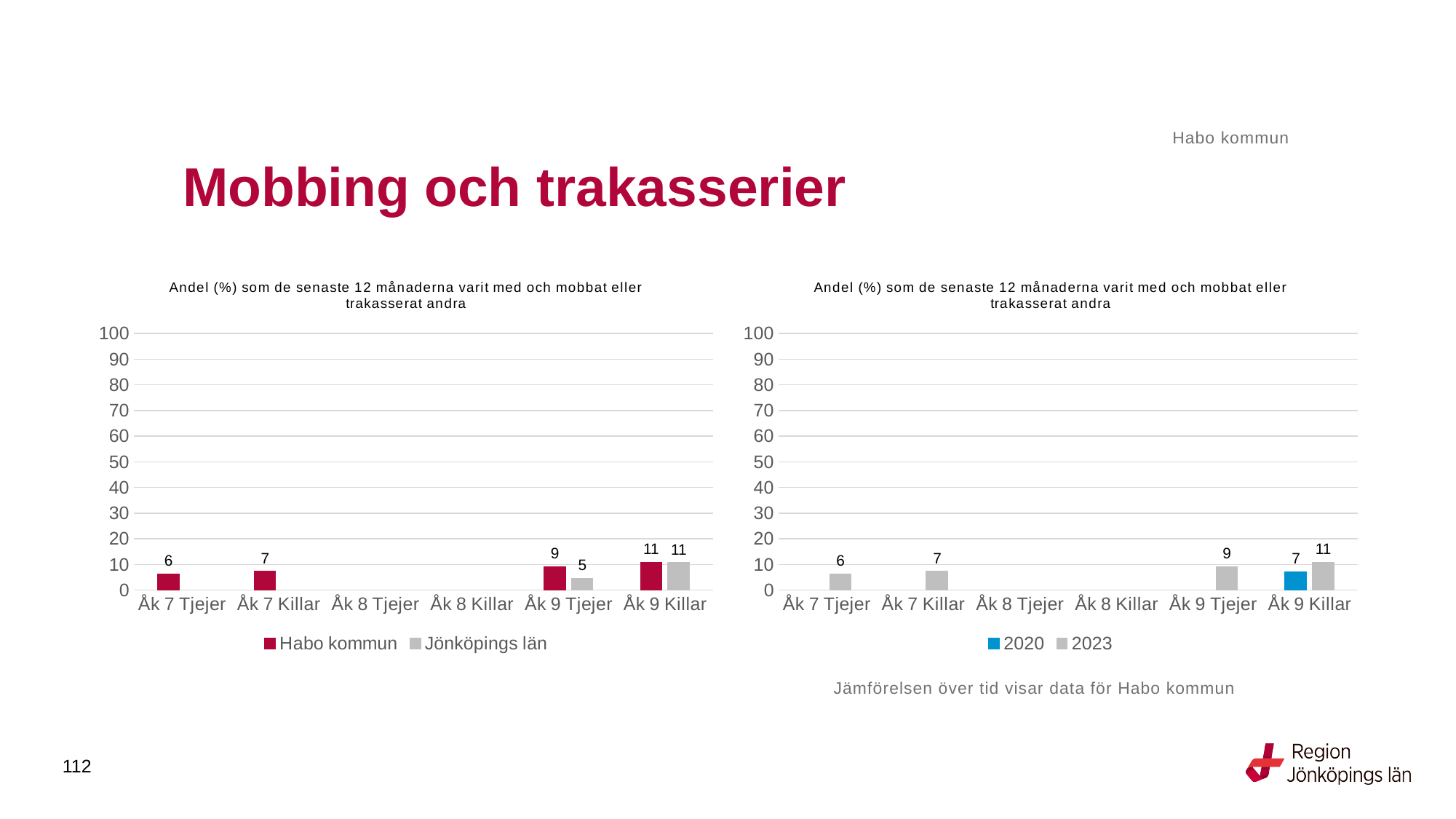
On the left chart, how many series does the legend list? 2 On the right chart, what is the value for 2020 for Åk 9 Killar? 7 On the right chart, what is the difference between 2023 and 2020 for Åk 9 Killar? 4 On the left chart, what is the difference between Habo kommun and Jönköpings län for Åk 9 Tjejer? 4 On the left chart, which category has the highest value for Habo kommun? Åk 9 Killar On the left chart, what is the value for Habo kommun for Åk 9 Killar? 11 On the left chart, what is the value for Habo kommun for Åk 7 Tjejer? 6 On the left chart, what is the value for Jönköpings län for Åk 9 Tjejer? 5 On the left chart, which is larger for Åk 9 Tjejer: Habo kommun or Jönköpings län? Habo kommun On the right chart, what kind of chart is shown? Bar chart On the right chart, what is the value for 2023 for Åk 7 Killar? 7 On the right chart, what are the two legend entries? 2020 and 2023